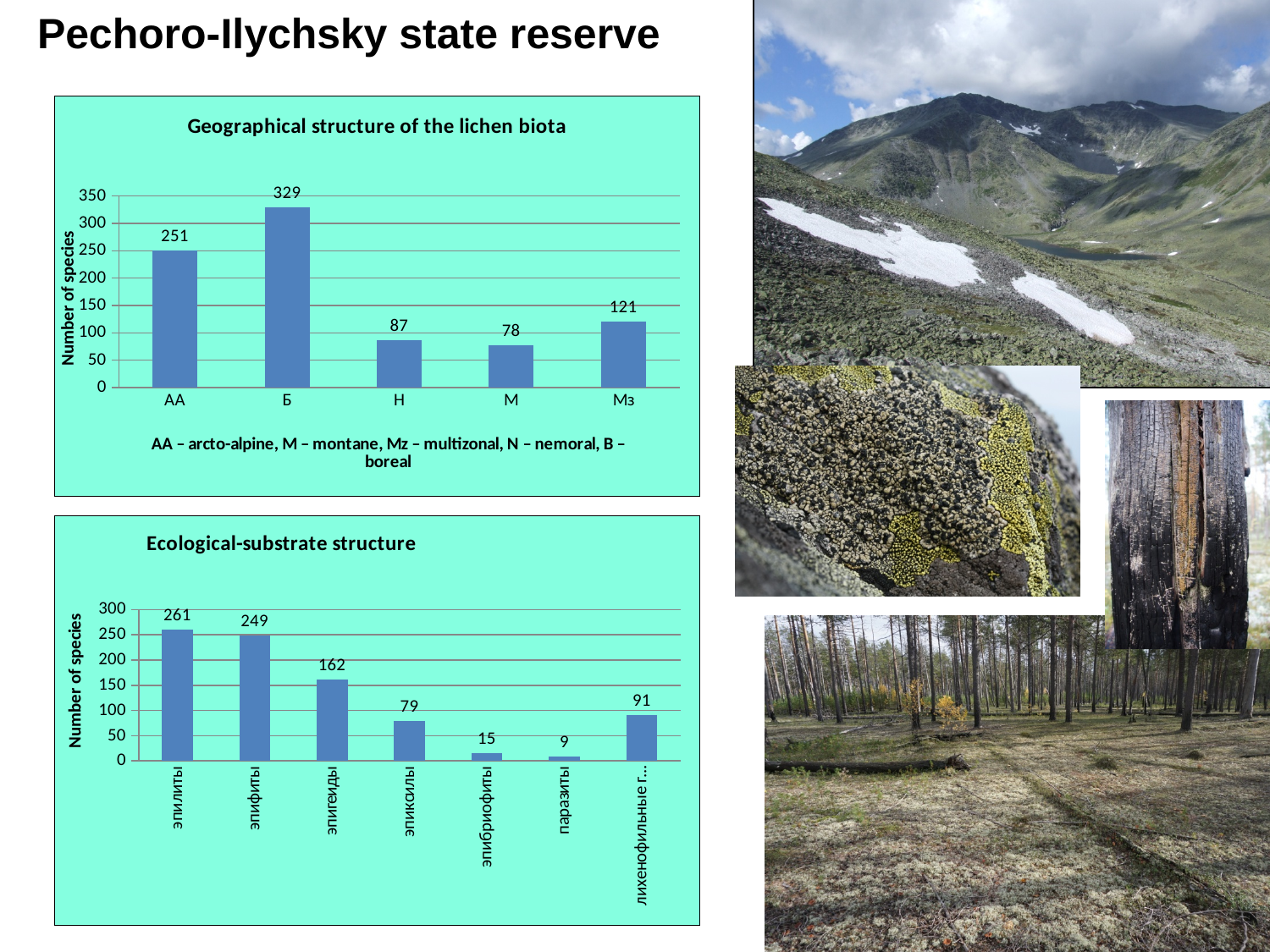
In the 'Geographical structure of the lichen biota' chart, how many categories are shown on the x axis? 5 In the 'Ecological-substrate structure' chart, which category has the lowest number of species? паразиты In the 'Ecological-substrate structure' chart, what is the difference between the values for эпилиты and эпифиты? 12 In the 'Geographical structure of the lichen biota' chart, what is the number of species for AA? 251 In the 'Ecological-substrate structure' chart, what is the number of species for эпигеиды? 162 In the 'Geographical structure of the lichen biota' chart, what is the number of species for Б? 329 What type of chart is the 'Ecological-substrate structure' chart? Bar chart In the 'Geographical structure of the lichen biota' chart, which category has the lowest number of species? М In the 'Geographical structure of the lichen biota' chart, which is larger, the value for Н or the value for Мз? Мз In the 'Geographical structure of the lichen biota' chart, what is the difference between the values for Б and AA? 78 In the 'Ecological-substrate structure' chart, which category has the highest number of species? эпилиты In the 'Ecological-substrate structure' chart, how many categories are shown on the x axis? 7